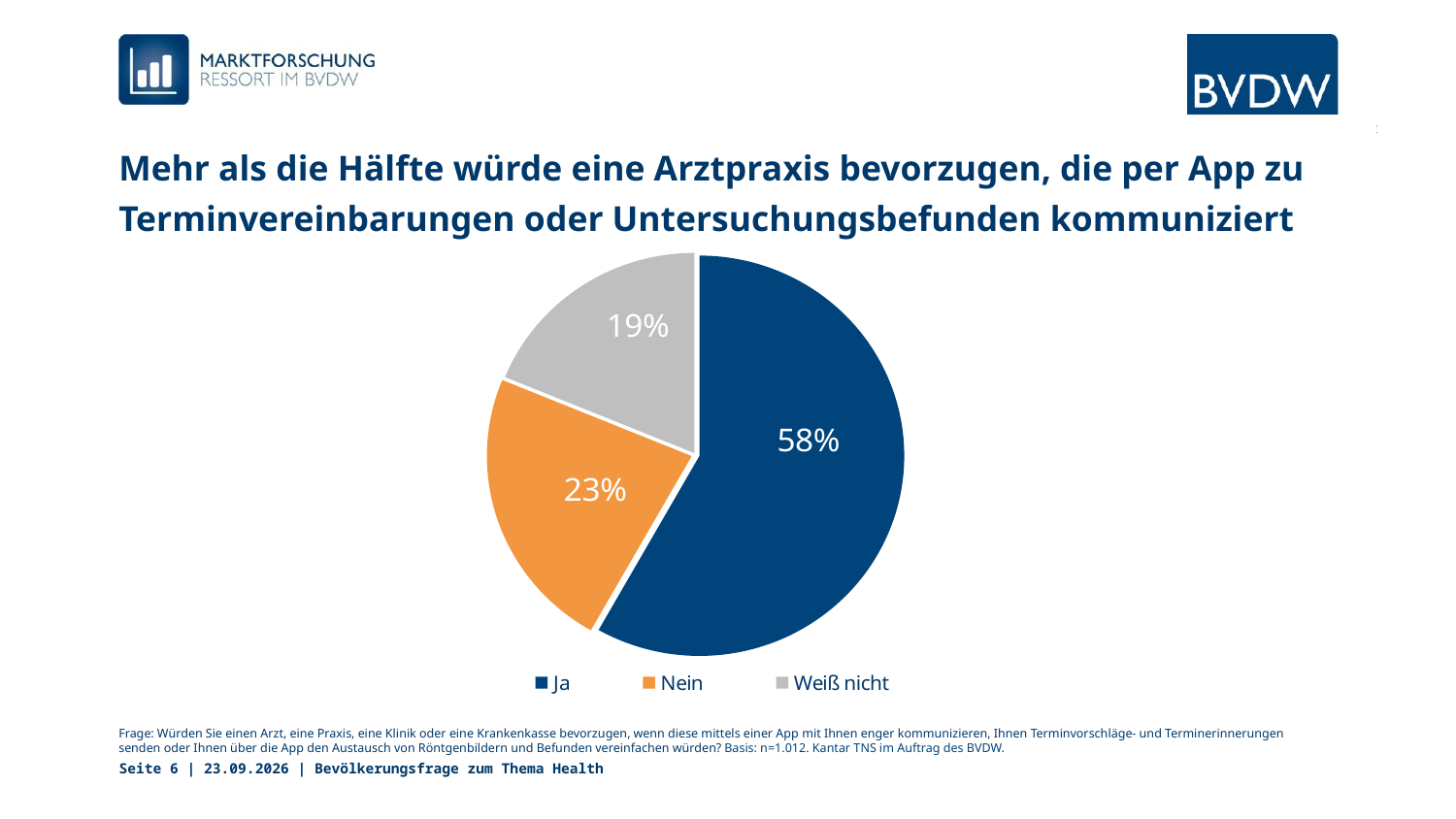
Which slice of the pie is the largest? Ja What kind of chart is shown on the slide? Pie chart What share of the pie is labelled "Nein"? 23% Which is larger, the "Nein" slice or the "Weiß nicht" slice? Nein How many slices does the pie chart have? 3 What share of the pie is labelled "Ja"? 58% What is the difference in percentage points between the "Nein" and "Weiß nicht" slices? 4 What are the three legend entries of the pie chart? Ja, Nein, Weiß nicht Which slice of the pie is the smallest? Weiß nicht What share of the pie is labelled "Weiß nicht"? 19% What colour is the "Nein" slice in the pie chart? Orange What is the difference in percentage points between the "Ja" and "Nein" slices? 35